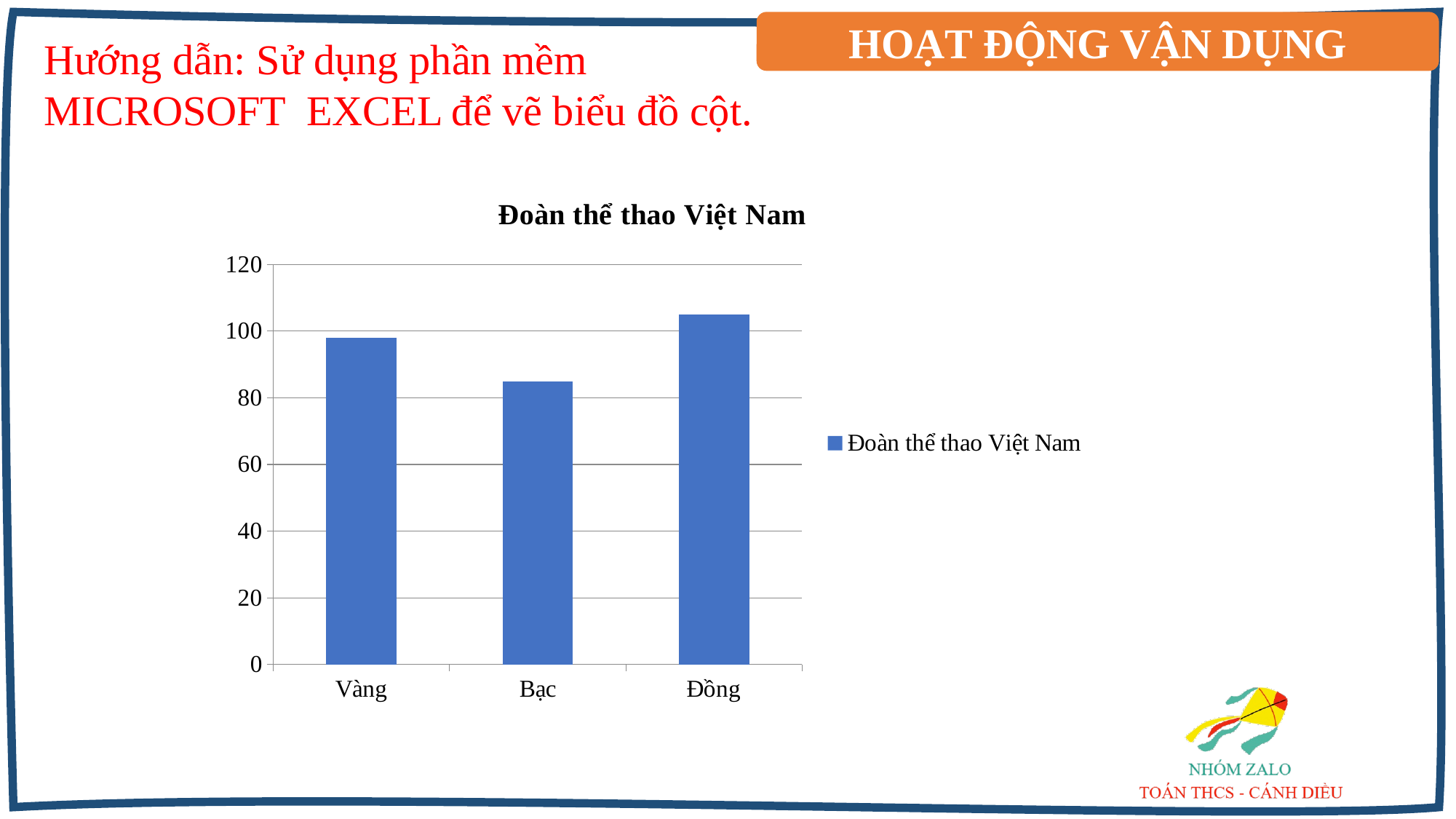
What kind of chart is shown on the slide? bar chart How many series does the chart legend list? 1 Which is larger, the value for Vàng or the value for Bạc? Vàng Which category has the lowest bar in the chart? Bạc Is the value for Vàng greater or less than 80? greater Which is larger, the value for Đồng or the value for Vàng? Đồng How many categories are shown on the x axis of the chart? 3 Is the value for Đồng greater or less than 100? greater What is the name of the series shown in the chart legend? Đoàn thể thao Việt Nam Which category has the highest bar in the chart? Đồng What is the title of the chart? Đoàn thể thao Việt Nam Is the value for Bạc greater or less than 100? less